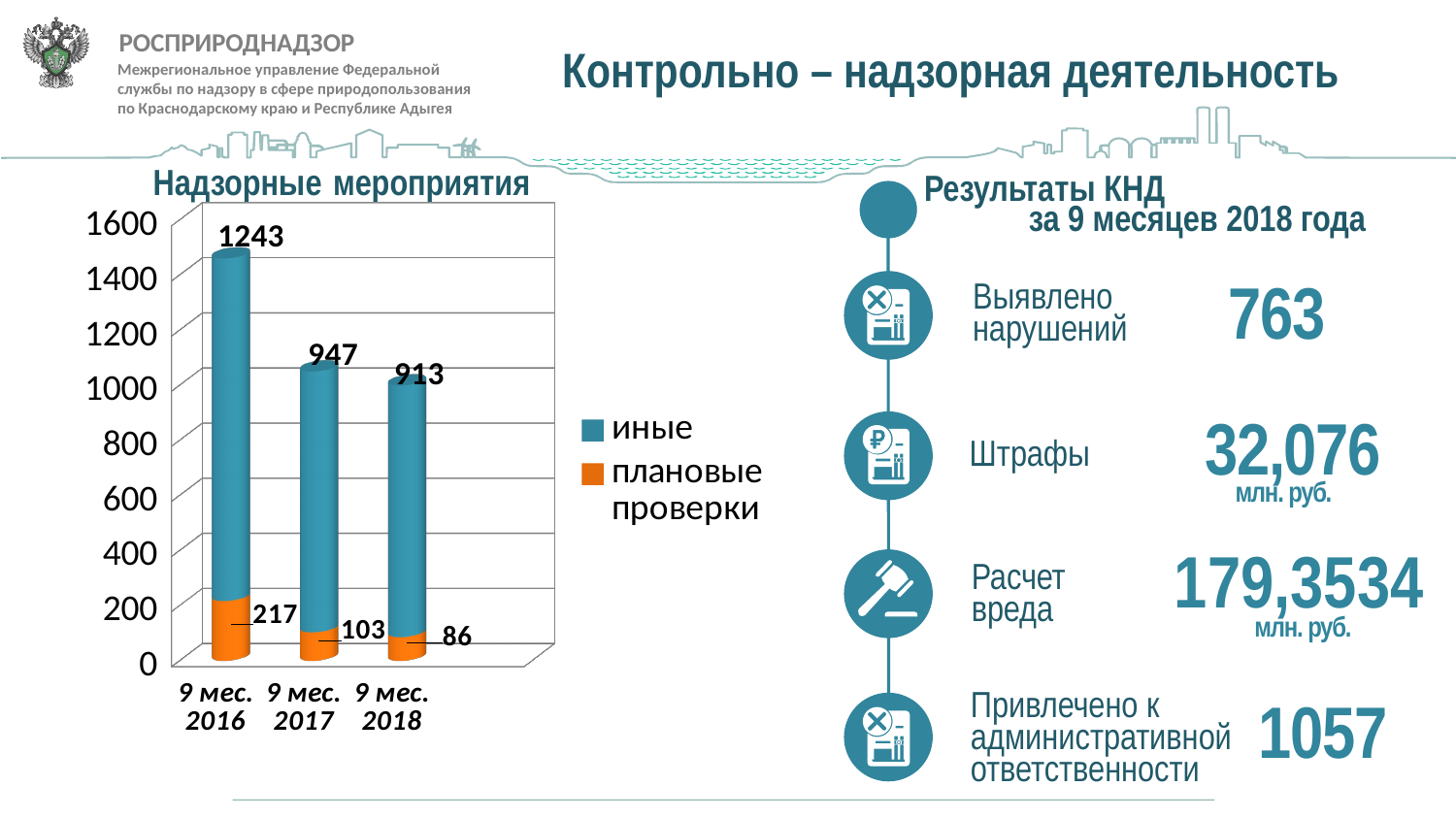
In the chart 'Надзорные мероприятия', what is the value of 'плановые проверки' for 9 мес. 2018? 86 In the chart 'Надзорные мероприятия', which period has the lowest value for 'иные'? 9 мес. 2018 In the chart 'Надзорные мероприятия', what is the value of 'иные' for 9 мес. 2016? 1243 How many series does the legend of the chart 'Надзорные мероприятия' list? 2 In the chart 'Надзорные мероприятия', which period has the highest value for 'плановые проверки'? 9 мес. 2016 In the chart 'Надзорные мероприятия', what is the difference between the 'иные' values for 9 мес. 2016 and 9 мес. 2017? 296 What kind of chart is 'Надзорные мероприятия'? Stacked bar chart In the chart 'Надзорные мероприятия', do the 'плановые проверки' values rise or fall from 9 мес. 2016 to 9 мес. 2018? Fall In the chart 'Надзорные мероприятия', what is the total of the stacked bar for 9 мес. 2016? 1460 How many periods (categories) are shown on the x axis of the chart 'Надзорные мероприятия'? 3 In the chart 'Надзорные мероприятия', which is larger: 'плановые проверки' for 9 мес. 2017 or for 9 мес. 2018? 9 мес. 2017 In the chart 'Надзорные мероприятия', what is the value of 'иные' for 9 мес. 2017? 947